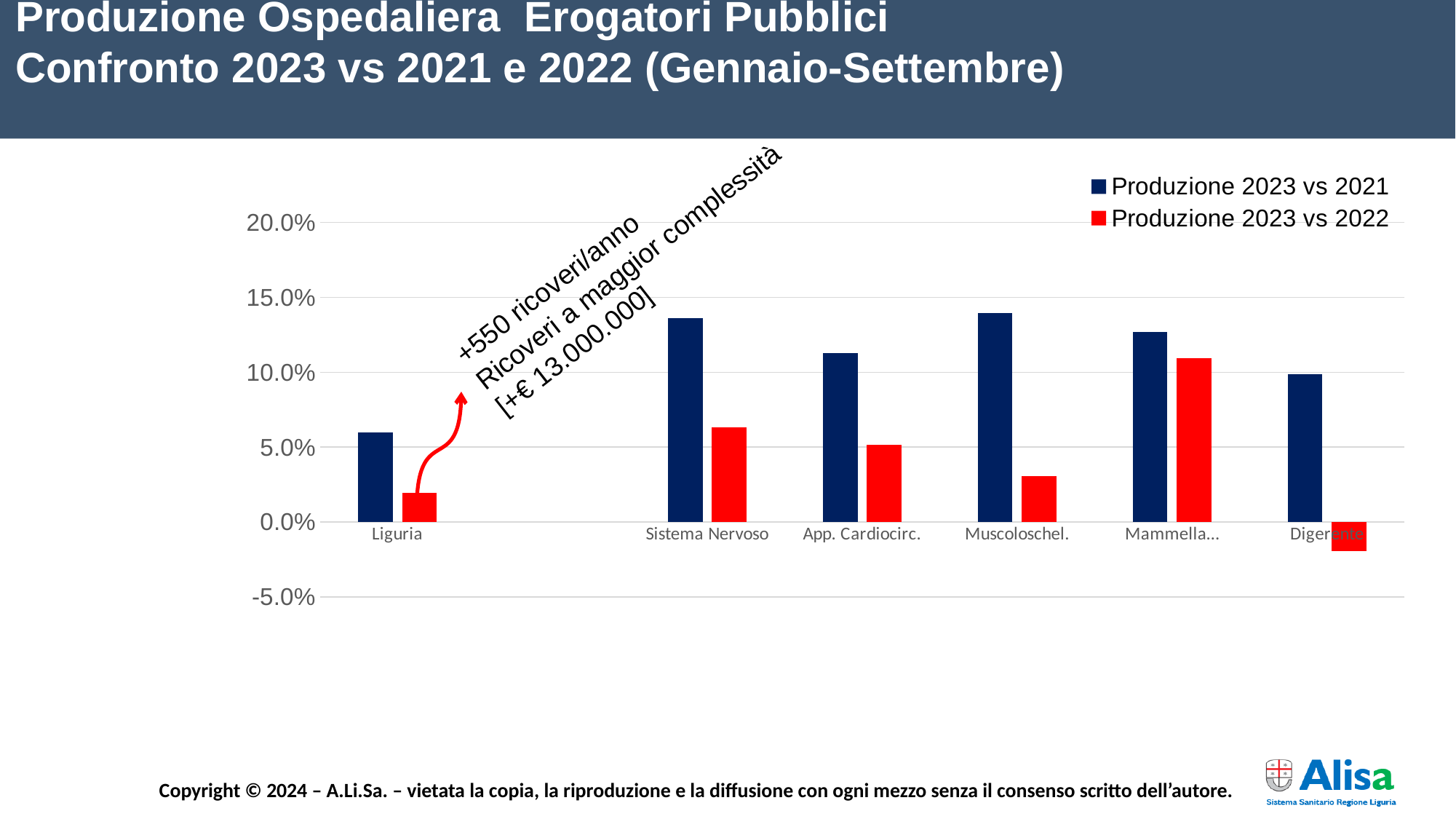
How many categories are shown on the x axis? 6 Is the value for Liguria in Produzione 2023 vs 2022 greater or less than 5.0%? less Is the value for Mammella... in Produzione 2023 vs 2022 greater or less than 10.0%? greater Which is larger for Produzione 2023 vs 2022: Mammella... or Muscoloschel.? Mammella... What colour are the bars for the Produzione 2023 vs 2022 series? red Is the value for Sistema Nervoso in Produzione 2023 vs 2021 greater or less than 10.0%? greater What kind of chart is shown on the slide? bar chart Which category has the highest value for Produzione 2023 vs 2022? Mammella... How many series does the legend list? 2 Which category has the lowest value for Produzione 2023 vs 2021? Liguria Which category has the lowest value for Produzione 2023 vs 2022? Digerente